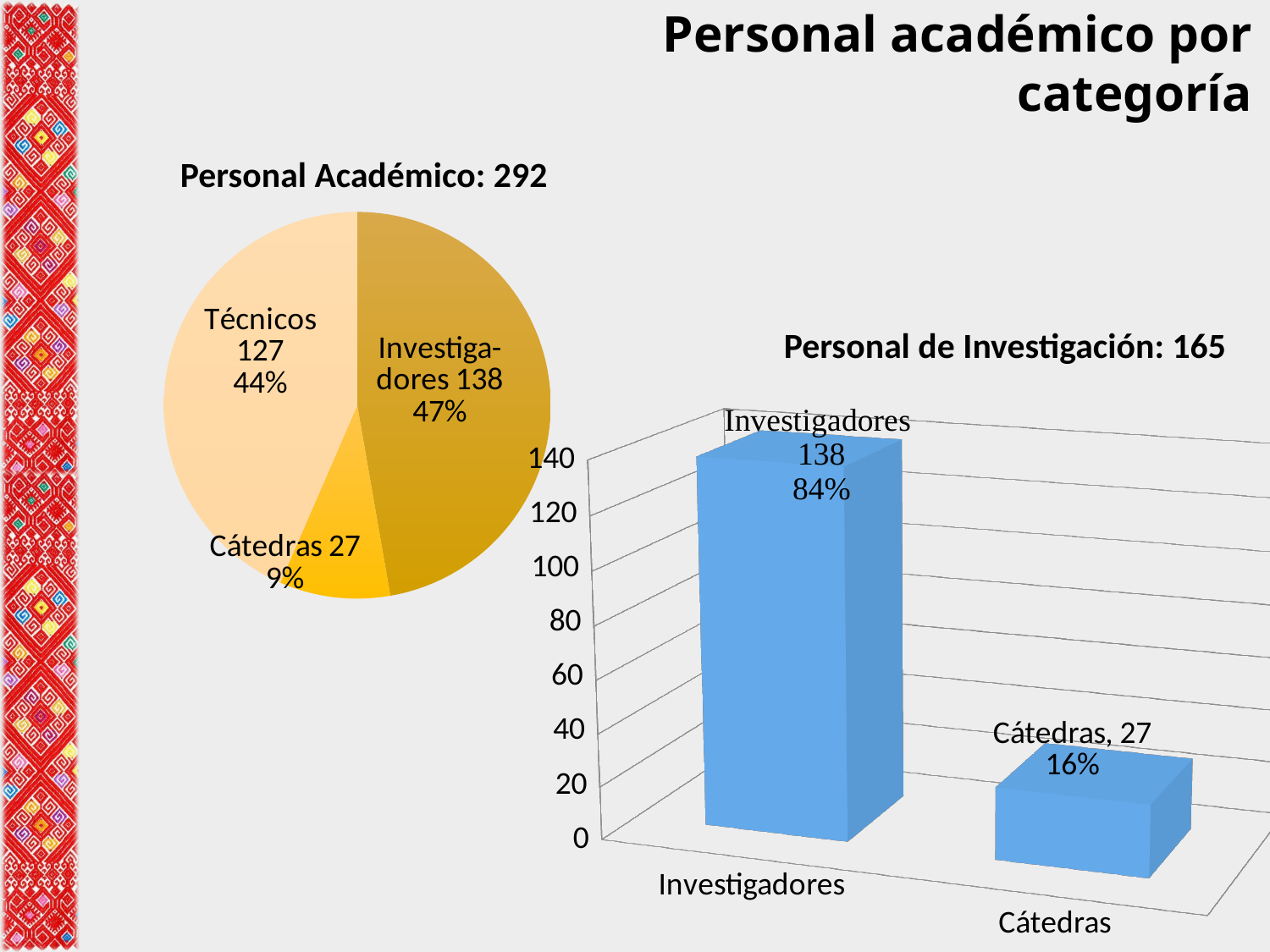
In the pie chart 'Personal Académico: 292', what percentage share do Investigadores have? 47% In the pie chart 'Personal Académico: 292', what is the difference between the number of Investigadores and Técnicos? 11 In the pie chart 'Personal Académico: 292', how many Técnicos are there? 127 In the pie chart 'Personal Académico: 292', which category has the smallest slice? Cátedras In the bar chart 'Personal de Investigación: 165', what percentage is shown for Investigadores? 84% In the bar chart 'Personal de Investigación: 165', what is the value for Cátedras? 27 What is the title of the slide? Personal académico por categoría In the bar chart 'Personal de Investigación: 165', what is the difference between Investigadores and Cátedras? 111 In the pie chart 'Personal Académico: 292', how many categories are shown? 3 In the bar chart 'Personal de Investigación: 165', which category has the higher value, Investigadores or Cátedras? Investigadores In the pie chart 'Personal Académico: 292', which category has the largest slice? Investigadores What kind of chart is 'Personal de Investigación: 165'? Bar chart